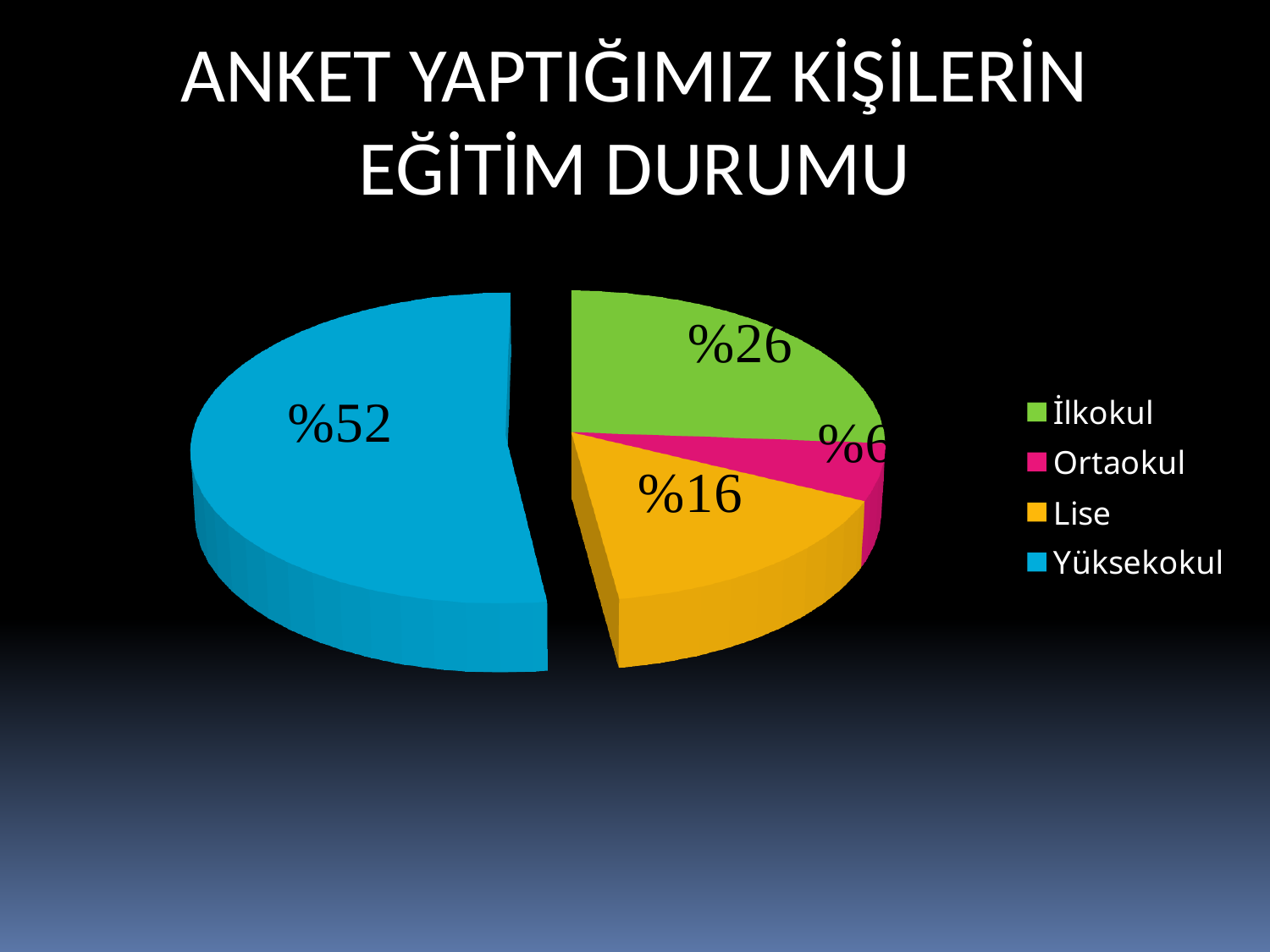
What share of the surveyed people have İlkokul education? %26 Which categories are listed in the legend? İlkokul, Ortaokul, Lise, Yüksekokul What colour is the Yüksekokul slice? blue What share of the surveyed people have Lise education? %16 Which education level has the smallest share of the pie? Ortaokul How many education categories does the pie chart show? 4 What kind of chart is shown on the slide? pie chart How many percentage points larger is the Yüksekokul share than the İlkokul share? 26 What share of the surveyed people have Yüksekokul education? %52 Which education level has the largest share of the pie? Yüksekokul Which is larger, the share for İlkokul or the share for Lise? İlkokul How many percentage points larger is the İlkokul share than the Lise share? 10